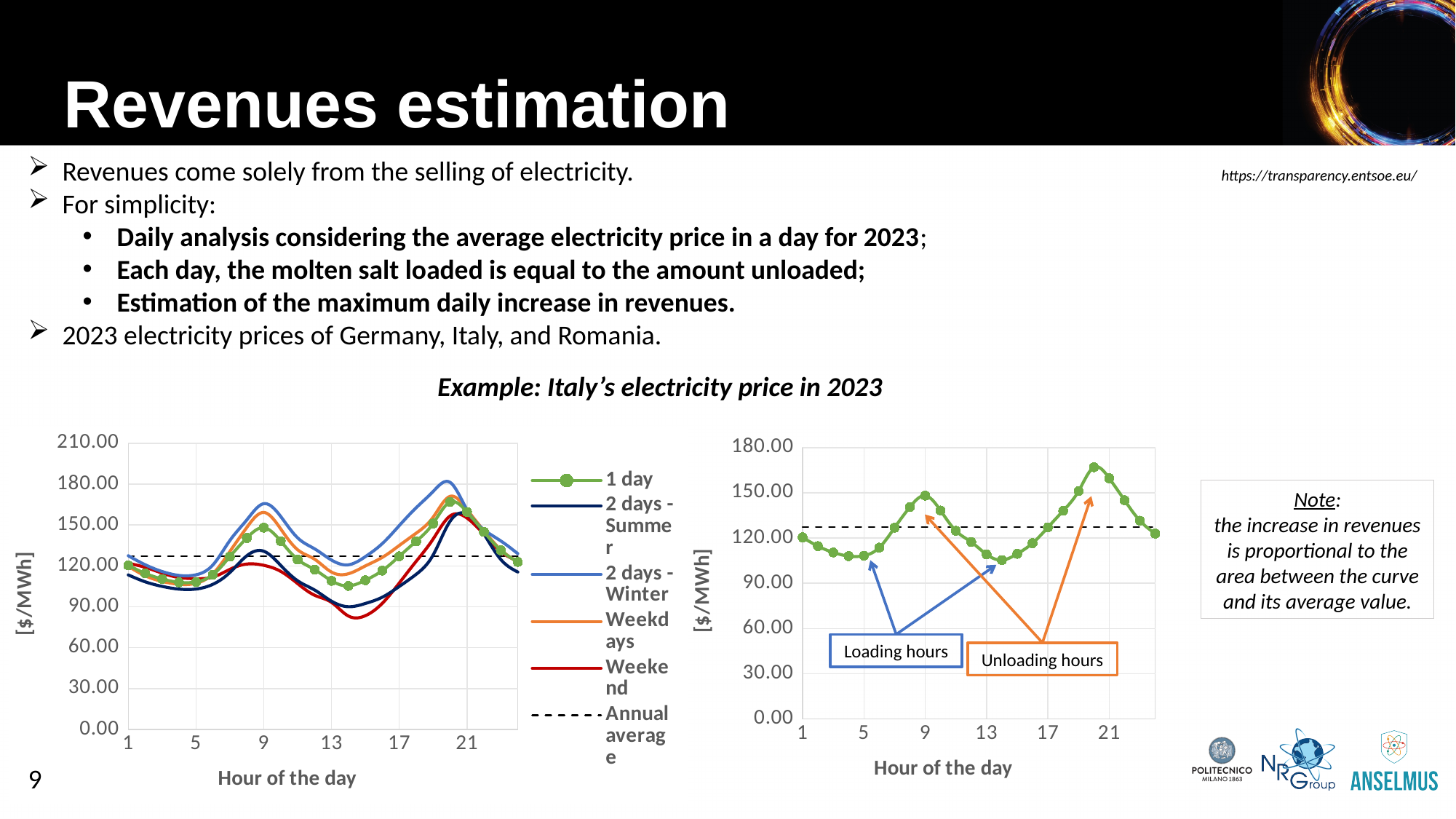
In the right chart, is the peak value around hour 20 greater or less than 150? greater In the left chart, at hour 14, is the 2 days - Winter value larger or smaller than the Weekend value? larger In the left chart, is the minimum value of the Weekend series greater or less than 90? less In the left chart, which series drops to the lowest value? Weekend In the left chart, which series reaches the highest peak value? 2 days - Winter What type of chart is the left chart on the slide? Line chart In the right chart, is the lowest value around hour 13 greater or less than 90? greater What is the y-axis label of the charts on the slide? [$/MWh] In the right chart, do the values rise or fall from hour 13 to hour 20? rise How many series does the legend of the left chart list? 6 How many data points are plotted in the right chart? 24 What does the dashed horizontal line in the left chart represent, according to the legend? Annual average